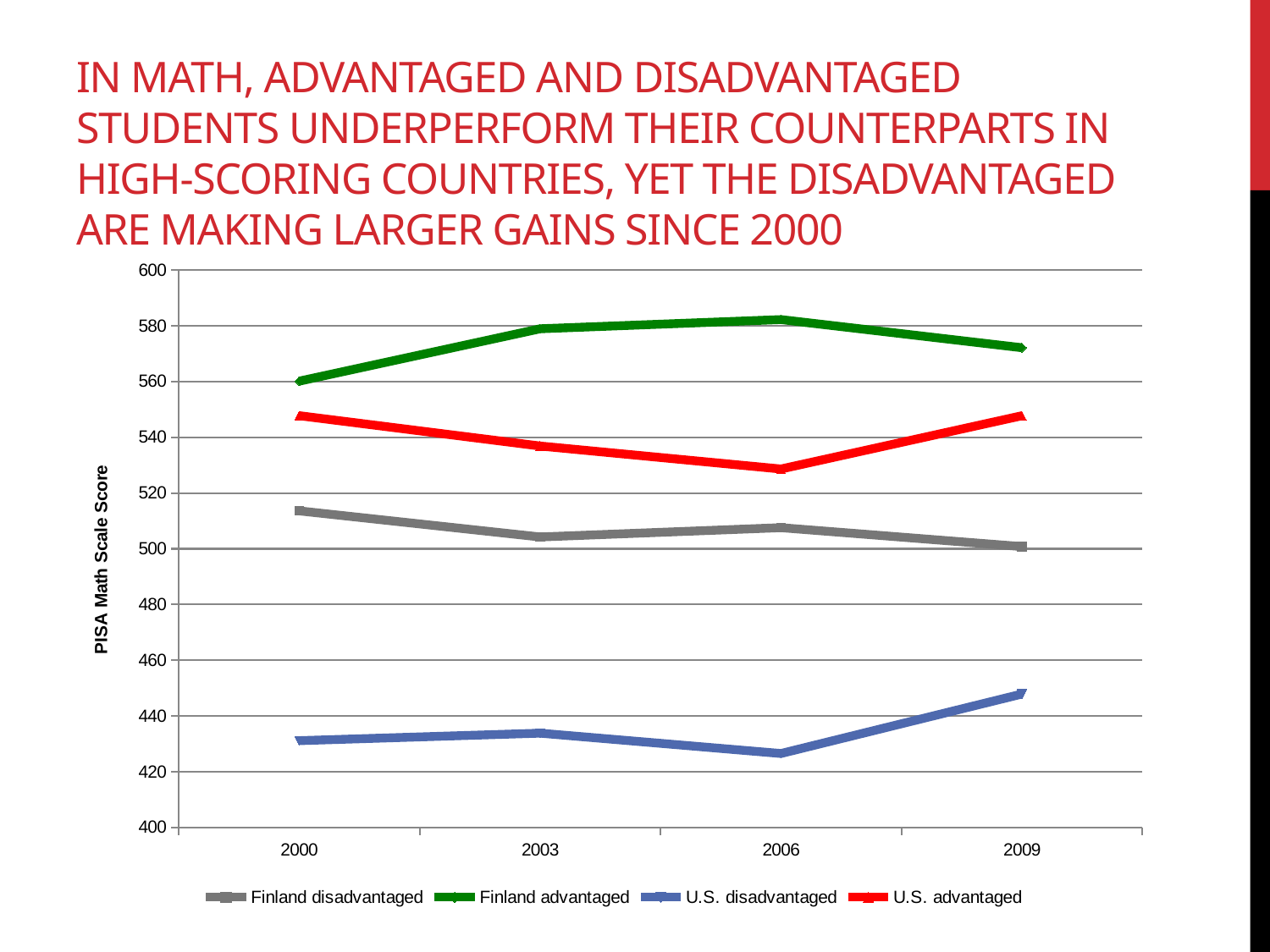
Which series has the highest value in 2009? Finland advantaged Is the value for Finland disadvantaged in 2009 greater or less than 520? less Which series has the lowest value in 2000? U.S. disadvantaged In which year is the U.S. advantaged line at its lowest? 2006 What is the title of the y axis? PISA Math Scale Score What kind of chart is shown on the slide? line chart How many series does the legend list? 4 How many years are plotted along the x axis? 4 Does the U.S. disadvantaged line rise or fall between 2006 and 2009? rise Is the value for U.S. advantaged in 2006 greater or less than 540? less In which year is the U.S. disadvantaged line at its highest? 2009 Is the value for U.S. disadvantaged in 2009 greater or less than 440? greater